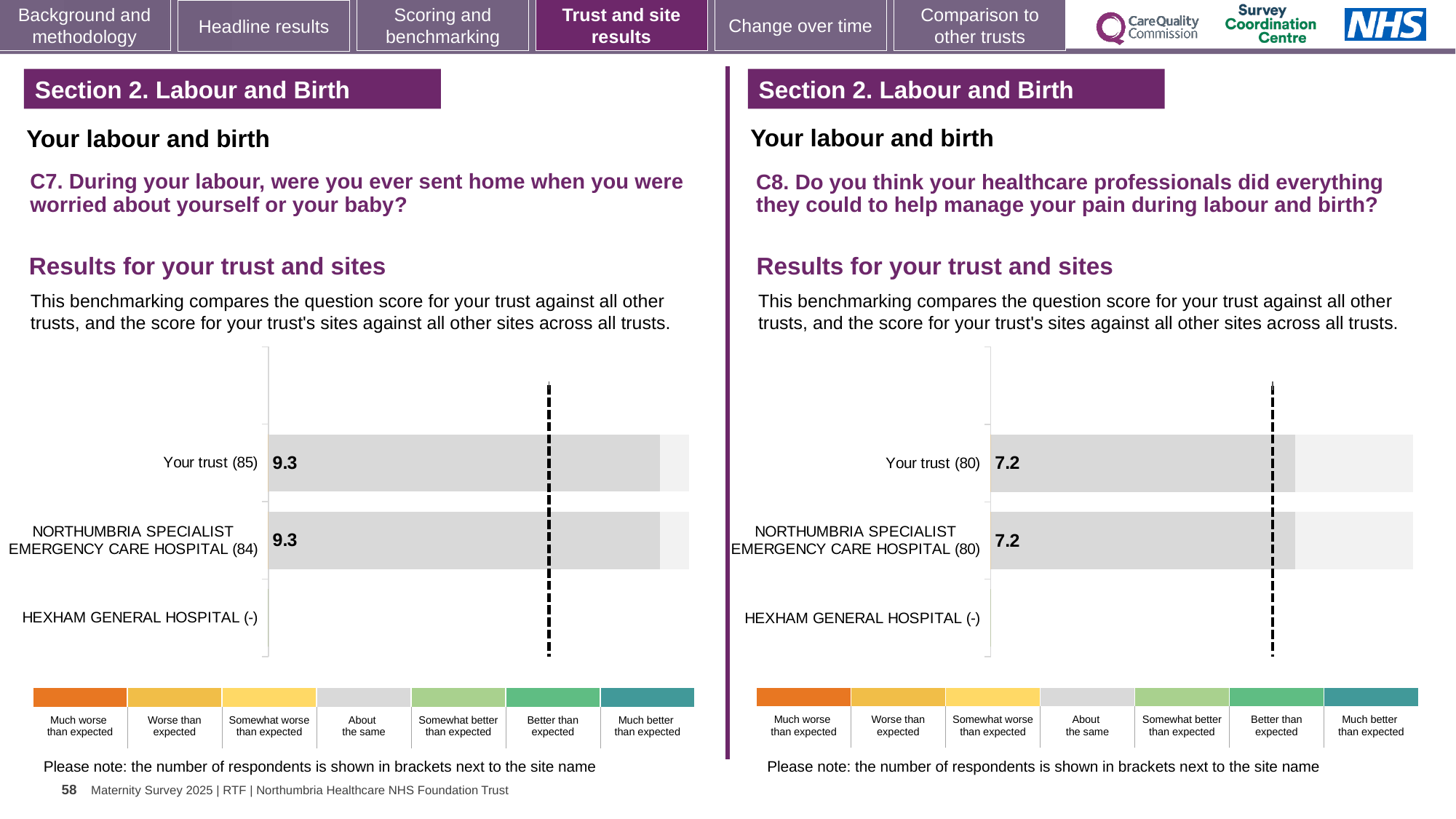
In the left chart (C7), which site has no score bar shown? Hexham General Hospital Which is larger: the Your trust score in the left chart (C7) or the Your trust score in the right chart (C8)? Left chart (C7) In the left chart (C7), what is the score for Northumbria Specialist Emergency Care Hospital? 9.3 In the right chart (C8), what is the score for Your trust? 7.2 What is the difference between the Your trust score in the left chart (C7) and the Your trust score in the right chart (C8)? 2.1 In the left chart (C7), is the score for Your trust equal to the score for Northumbria Specialist Emergency Care Hospital? Yes In the left chart (C7), how many respondents are shown in brackets for Your trust? 85 In the right chart (C8), how many respondents are shown in brackets for Northumbria Specialist Emergency Care Hospital? 80 How many categories are listed on the y axis of the left chart (C7)? 3 In the right chart (C8), what is the score for Northumbria Specialist Emergency Care Hospital? 7.2 What kind of chart is used in the right chart (C8)? Bar chart In the left chart (C7), what is the score for Your trust? 9.3